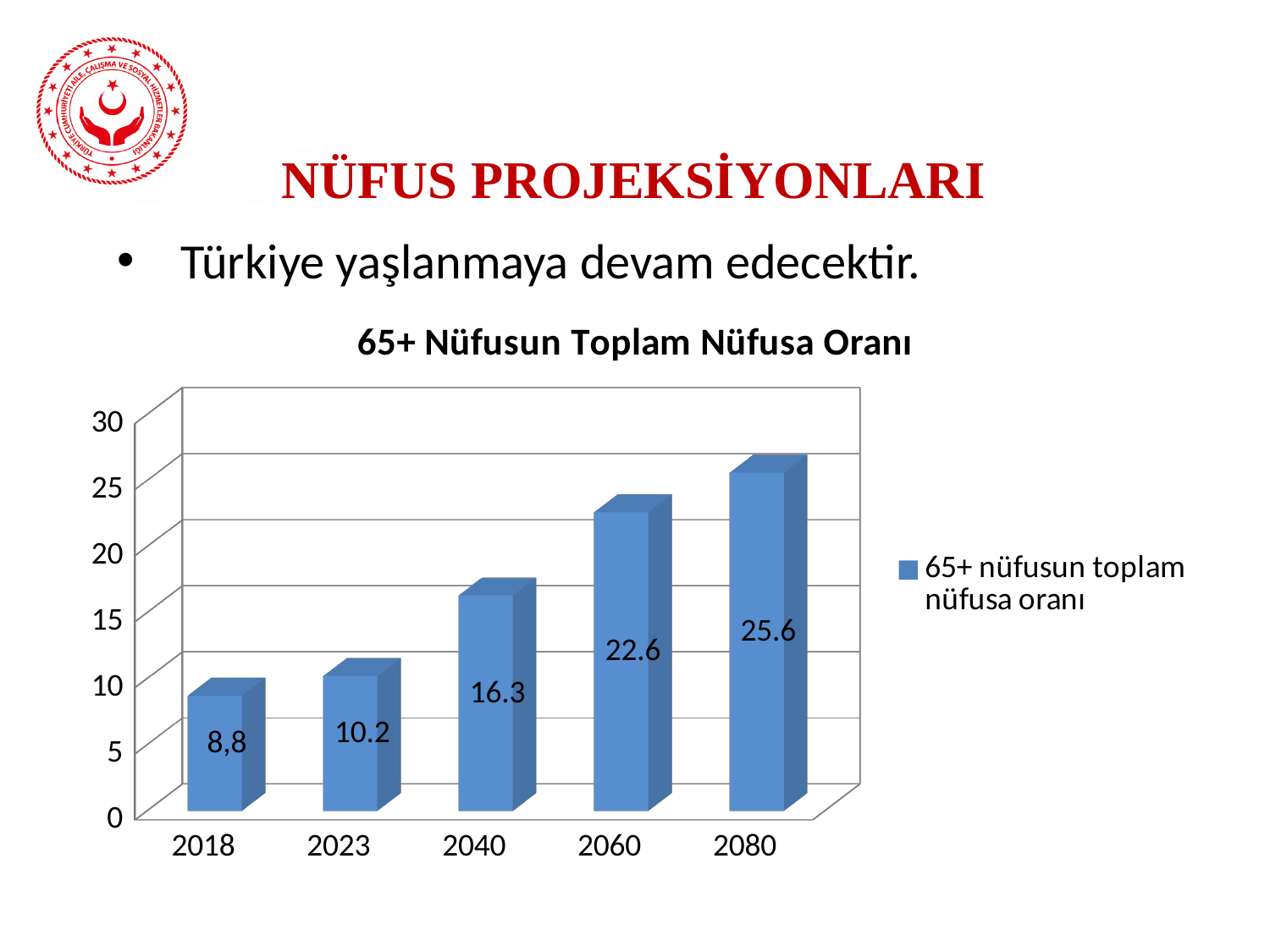
Which year has the highest value? 2080 What is the value for 2040? 16.3 Which is larger, the value for 2060 or the value for 2040? 2060 How many years are shown on the x axis? 5 Is the value for 2060 greater or less than 20? greater What is the difference between the values for 2080 and 2060? 3.0 Which year has the lowest value? 2018 What is the title of the chart? 65+ Nüfusun Toplam Nüfusa Oranı What is the value for 2080? 25.6 What is the difference between the values for 2040 and 2023? 6.1 What is the value for 2018? 8,8 What kind of chart is this? bar chart